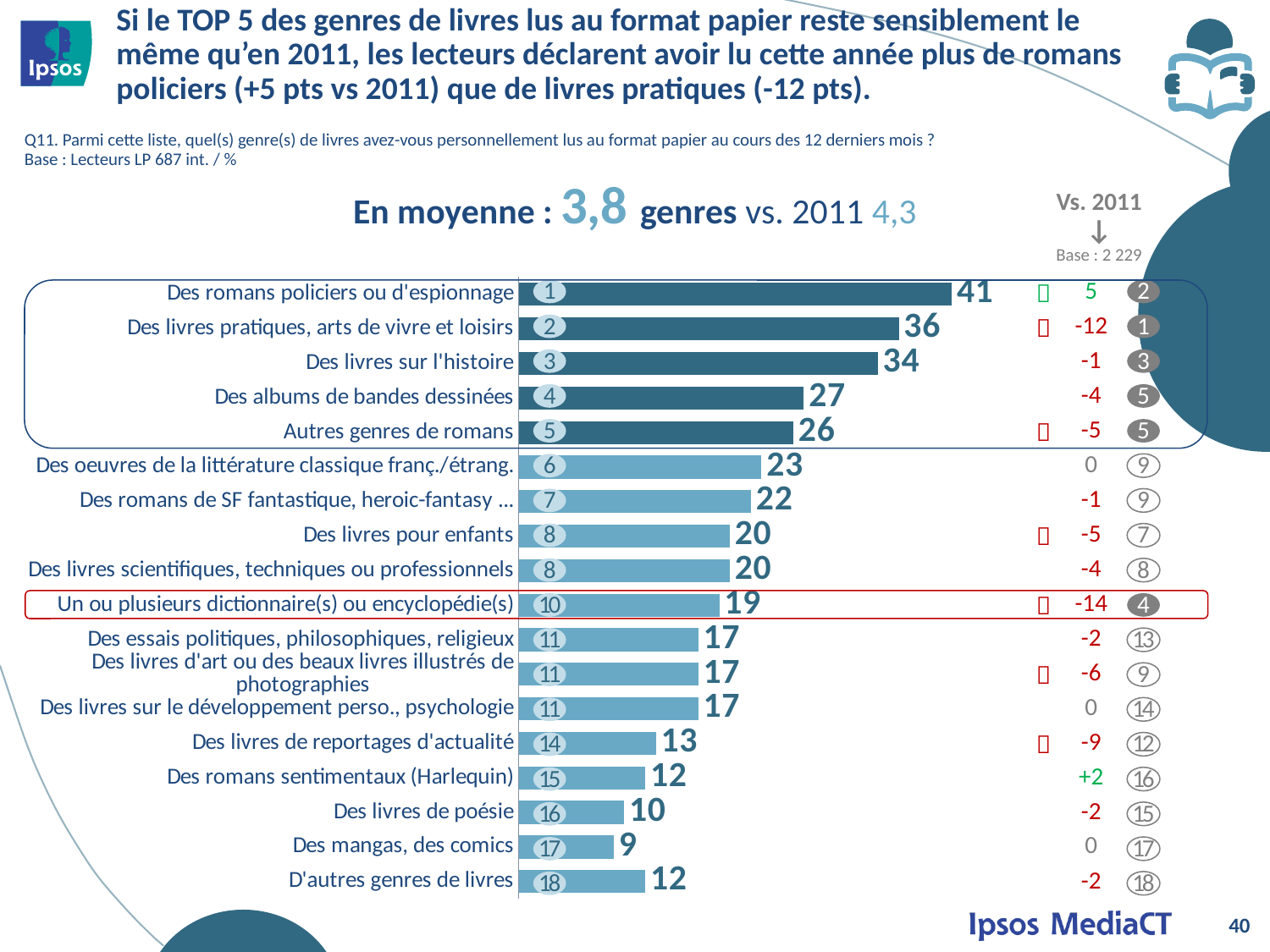
What is the value for "Des romans policiers ou d'espionnage"? 41 What is the value for "Des livres de poésie"? 10 Which genre has the lowest value in the chart? Des mangas, des comics Which genre has the highest value in the chart? Des romans policiers ou d'espionnage What is the change vs. 2011 shown for "Des livres pratiques, arts de vivre et loisirs"? -12 How many genres (bars) are shown in the chart? 18 What is the value for "Des livres sur l'histoire"? 34 What average number of genres is stated above the chart ("En moyenne")? 3,8 What kind of chart is shown on the slide? bar chart What is the change vs. 2011 shown for "Un ou plusieurs dictionnaire(s) ou encyclopédie(s)"? -14 Which is larger, the value for "Des albums de bandes dessinées" or the value for "Des livres pour enfants"? Des albums de bandes dessinées What is the difference between the values for "Des romans policiers ou d'espionnage" and "Des livres pratiques, arts de vivre et loisirs"? 5